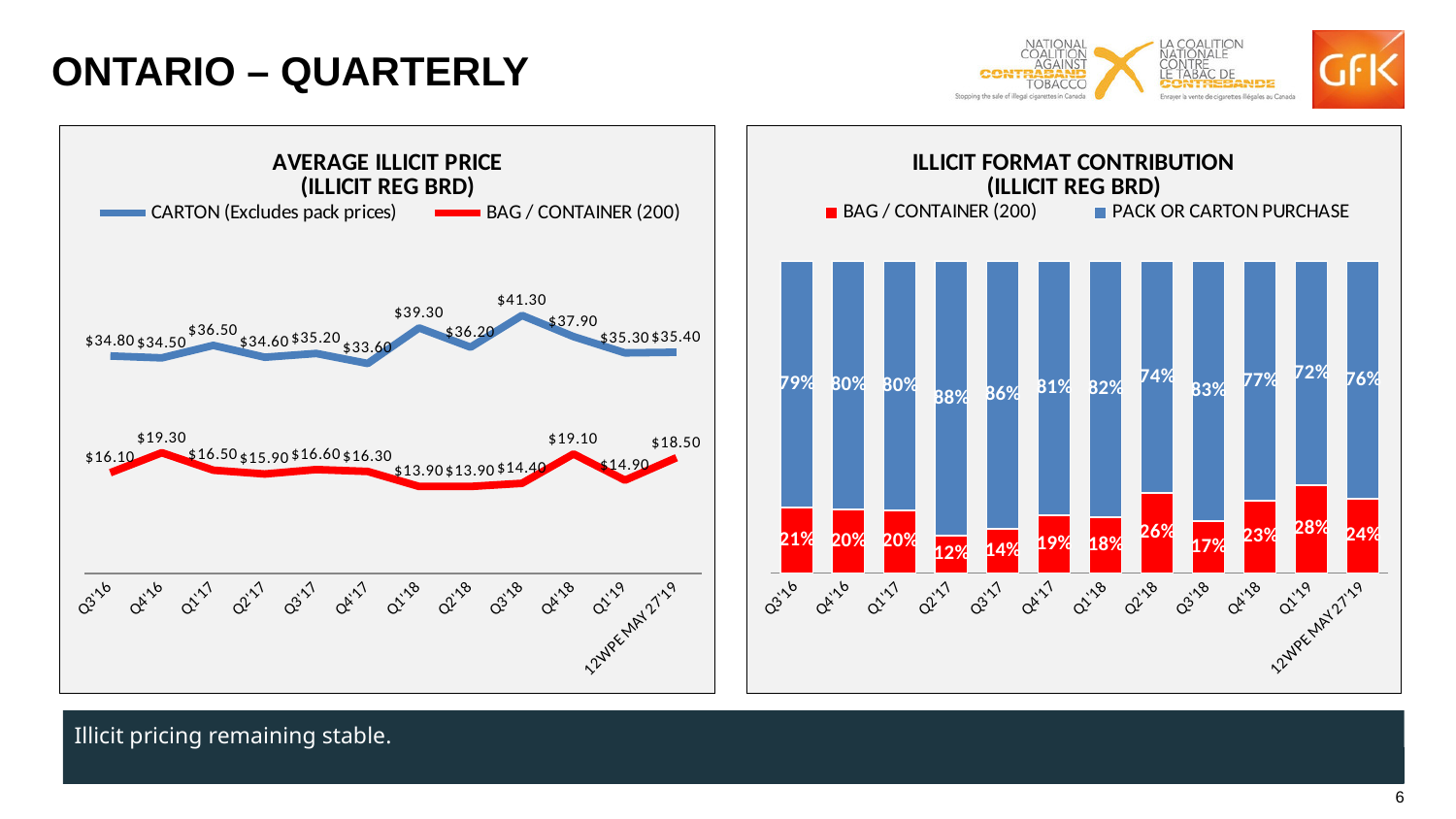
In the ILLICIT FORMAT CONTRIBUTION chart, how many quarters are shown on the x axis? 12 In the AVERAGE ILLICIT PRICE chart, which quarter has the highest CARTON price? Q3'18 In the AVERAGE ILLICIT PRICE chart, what is the difference between the CARTON price and the BAG / CONTAINER (200) price for 12WPE MAY 27'19? $16.90 In the AVERAGE ILLICIT PRICE chart, what is the BAG / CONTAINER (200) price for Q4'16? $19.30 In the ILLICIT FORMAT CONTRIBUTION chart, which quarter has the lowest BAG / CONTAINER (200) share? Q2'17 In the ILLICIT FORMAT CONTRIBUTION chart, what is the PACK OR CARTON PURCHASE share for Q2'17? 88% In the ILLICIT FORMAT CONTRIBUTION chart, what is the BAG / CONTAINER (200) share for Q1'19? 28% What kind of chart is the AVERAGE ILLICIT PRICE chart? Line chart In the AVERAGE ILLICIT PRICE chart, what is the CARTON price for Q3'18? $41.30 In the ILLICIT FORMAT CONTRIBUTION chart, is the PACK OR CARTON PURCHASE share larger in Q3'18 or Q2'18? Q3'18 In the AVERAGE ILLICIT PRICE chart, how many series does the legend list? 2 In the AVERAGE ILLICIT PRICE chart, which quarter has the lowest CARTON price? Q4'17